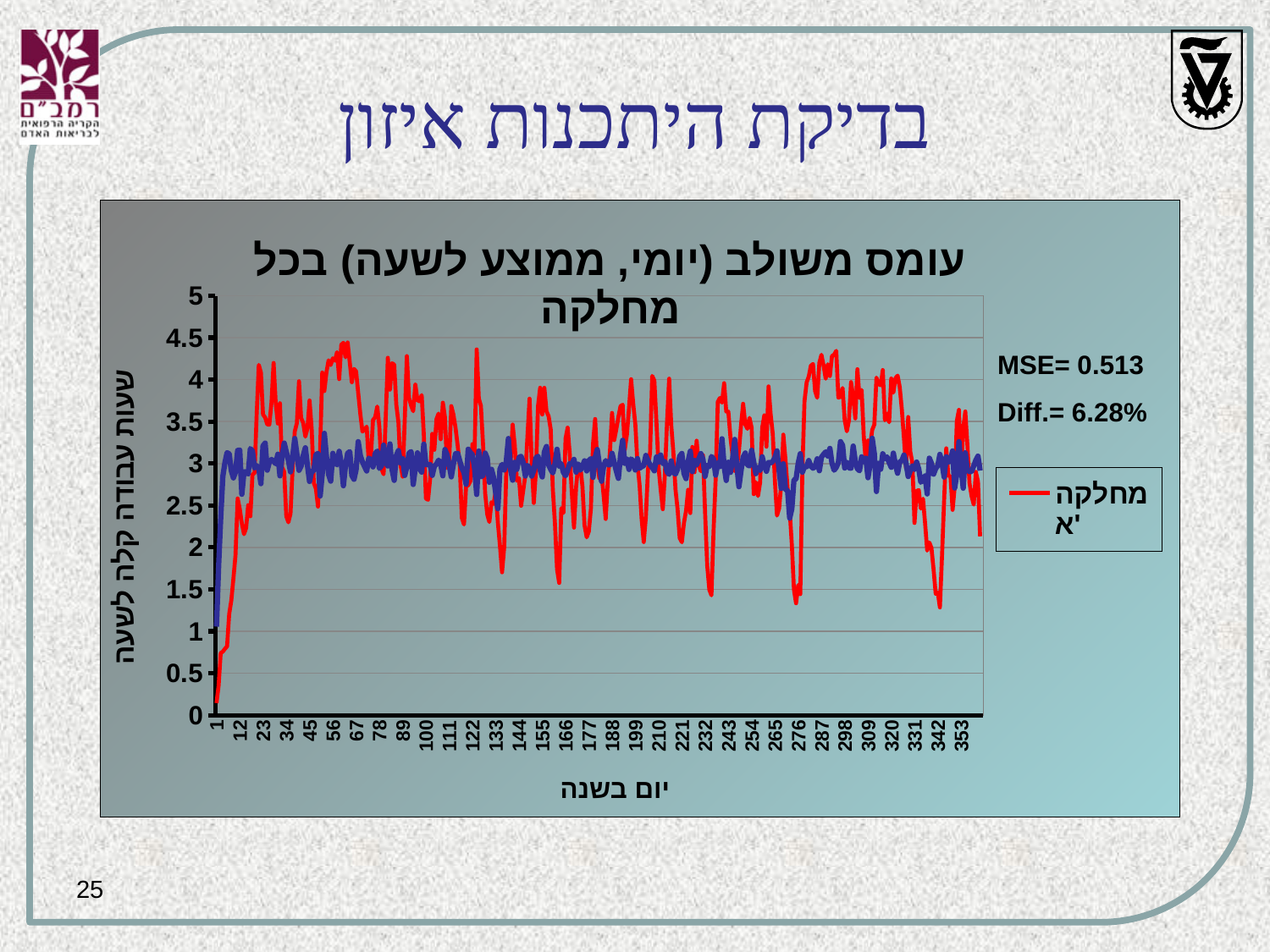
Is the lowest value of the red line, near day 342, greater or less than 2? less What Diff. value is printed next to the chart? 6.28% Does the blue line rise, fall, or stay roughly flat across the days of the year? roughly flat Is the value of the red line at day 1 greater or less than 1? less What MSE value is printed next to the chart? 0.513 How many series does the chart's legend list? 1 Is the highest value of the red line, near day 67, greater or less than 4? greater What is the label of the chart's x axis? יום בשנה What is the highest tick value shown on the chart's y axis? 5 What kind of chart is shown on the slide? line chart What is the name of the series listed in the chart's legend? מחלקה א'